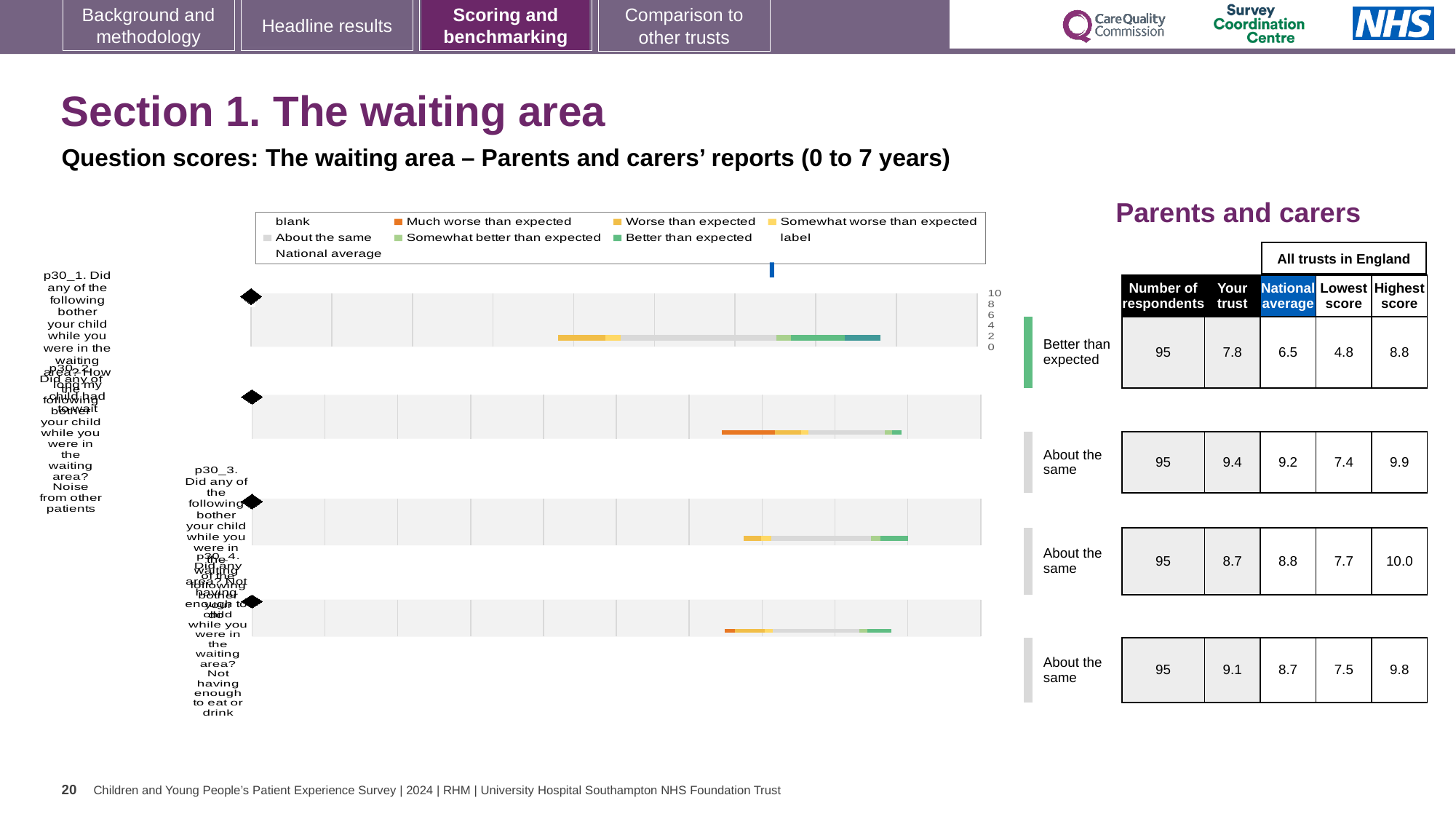
What kind of chart is shown on the slide? bar chart Which colour does the legend use for 'About the same'? grey In the table beside the chart, which row has the lowest 'Your trust' score? the first row (7.8) In the table beside the chart, is the 'Your trust' score in the third row larger or smaller than the national average? smaller In the table beside the chart, how many respondents are listed for each row? 95 How many entries does the chart legend list? 9 In the table beside the chart, what is the 'Your trust' score for the first row (Better than expected)? 7.8 In the table beside the chart, which row has the highest 'Your trust' score? the second row (9.4) In the table beside the chart, what is the difference between the 'Your trust' score and the national average in the first row? 1.3 Which colour does the legend use for 'Much worse than expected'? orange How many question rows (bars) are plotted in the chart? 4 In the table beside the chart, what is the national average for the second row? 9.2